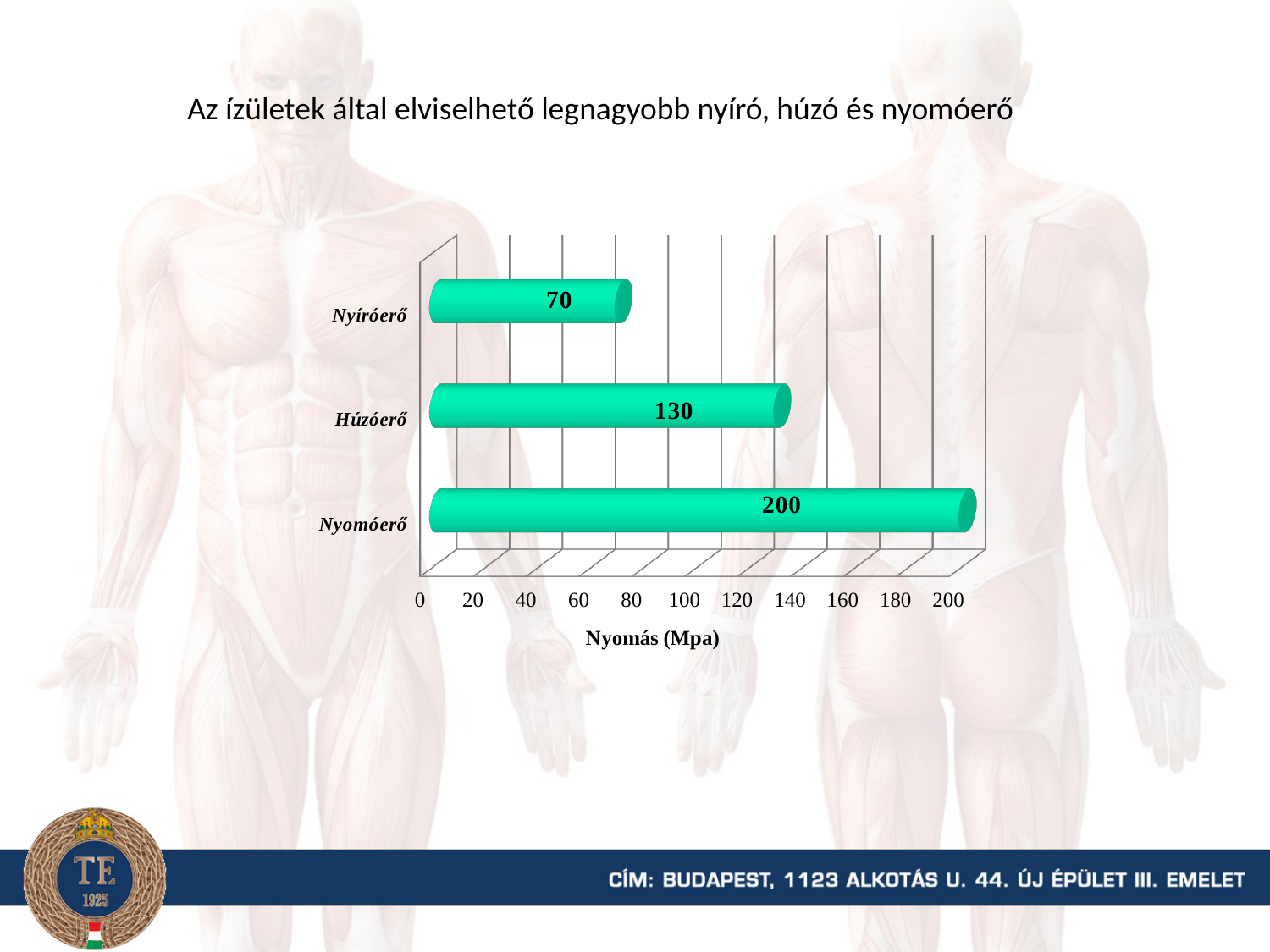
What is the difference between the values for Nyomóerő and Húzóerő? 70 What kind of chart is shown on the slide? bar chart Is the value for Húzóerő greater or less than 100? greater What is the value for Nyíróerő? 70 What is the value for Húzóerő? 130 What is the difference between the values for Húzóerő and Nyíróerő? 60 How many categories are shown in the chart? 3 What is the value for Nyomóerő? 200 Which category has the lowest value? Nyíróerő Which is larger, the value for Húzóerő or the value for Nyíróerő? Húzóerő What is the label of the horizontal axis? Nyomás (Mpa) Which category has the highest value? Nyomóerő